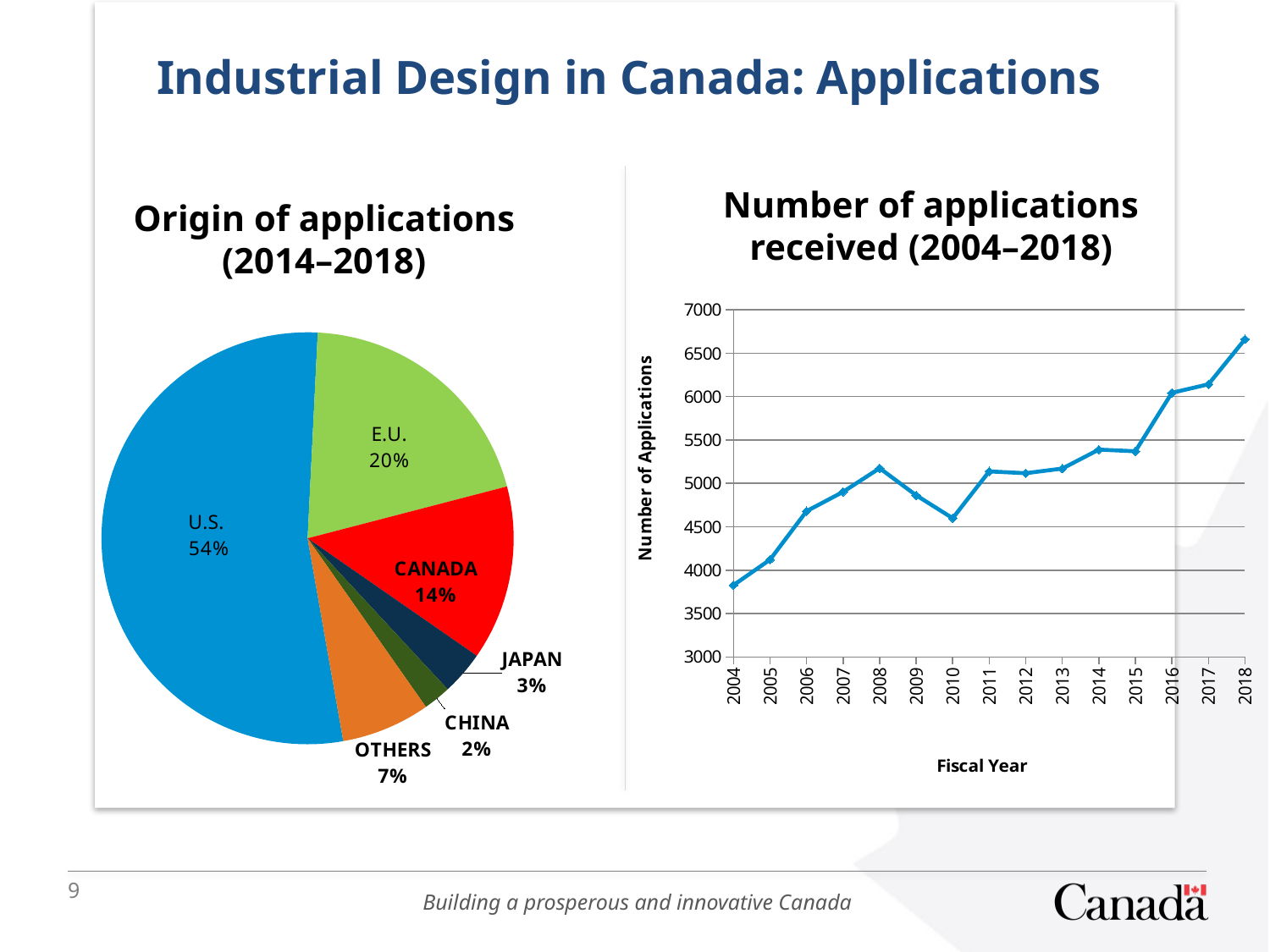
In the 'Number of applications received (2004–2018)' chart, is the value for 2018 greater or less than 6500? greater In the 'Origin of applications (2014–2018)' pie chart, what share of applications comes from the U.S.? 54% How many slices does the 'Origin of applications (2014–2018)' pie chart have? 6 What kind of chart is the chart on the left of the slide? Pie chart In the 'Origin of applications (2014–2018)' pie chart, which origin has the largest share? U.S. What kind of chart is the 'Number of applications received (2004–2018)' chart? Line chart In the 'Number of applications received (2004–2018)' chart, which year has the highest number of applications? 2018 In the 'Origin of applications (2014–2018)' pie chart, how many percentage points larger is the E.U. share than the Canada share? 6 In the 'Origin of applications (2014–2018)' pie chart, which is larger, the share for Japan or the share for Others? Others In the 'Origin of applications (2014–2018)' pie chart, which origin has the smallest share? China In the 'Number of applications received (2004–2018)' chart, is the value for 2004 greater or less than 4000? less In the 'Origin of applications (2014–2018)' pie chart, what share of applications comes from Canada? 14%